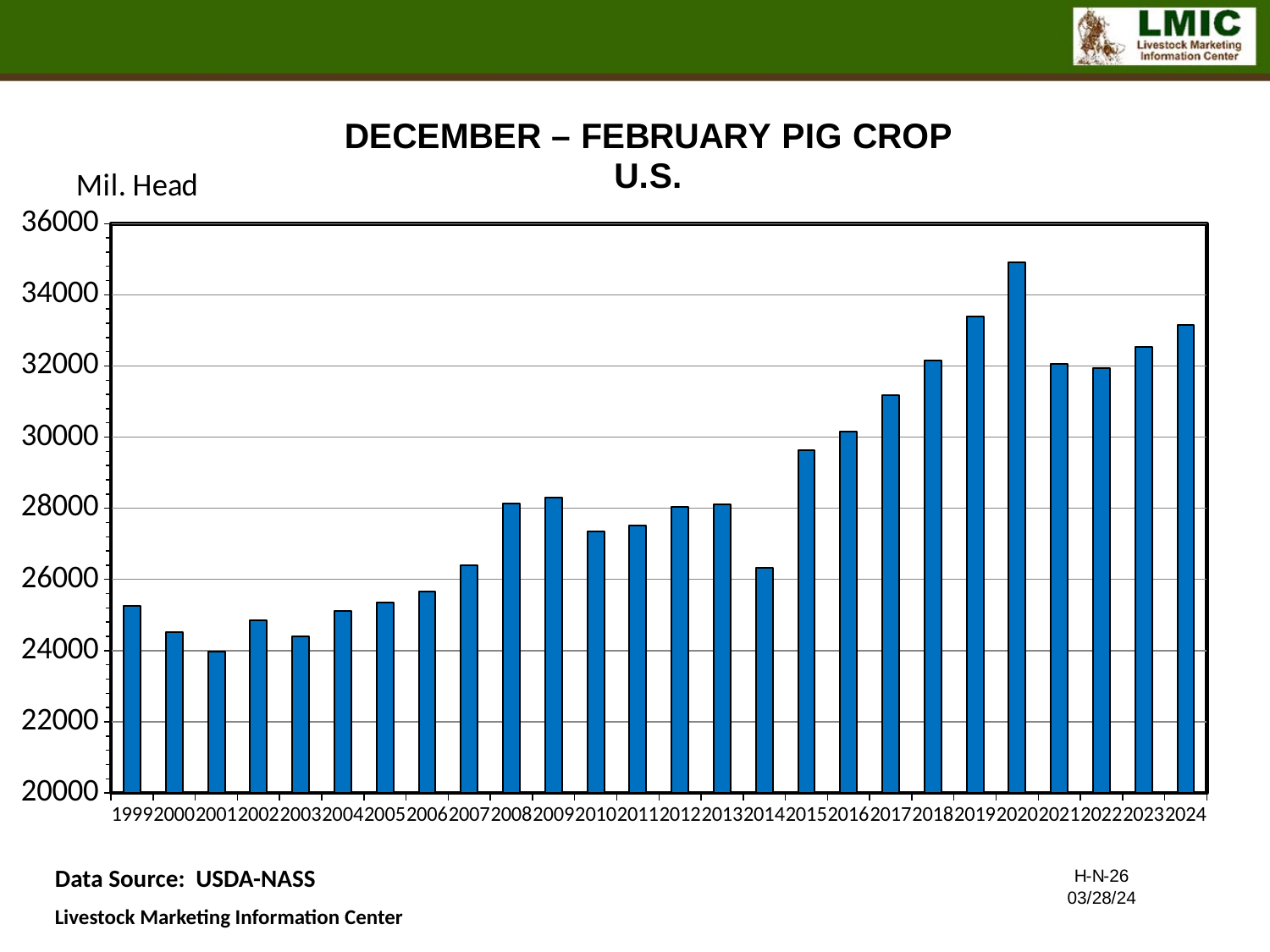
How many years (bars) are plotted on the chart? 26 Which year has the larger pig crop, 2013 or 2014? 2013 Is the value for 2019 greater or less than 32000? greater Which year has the lowest December–February pig crop? 2001 Which year has the highest December–February pig crop? 2020 Overall, do the values rise or fall from 1999 to 2024? rise Which year has the larger pig crop, 2020 or 2024? 2020 Is the value for 2014 greater or less than 28000? less What kind of chart is shown on the slide? bar chart Is the value for 2015 greater or less than 30000? less What unit is shown on the vertical axis label? Mil. Head